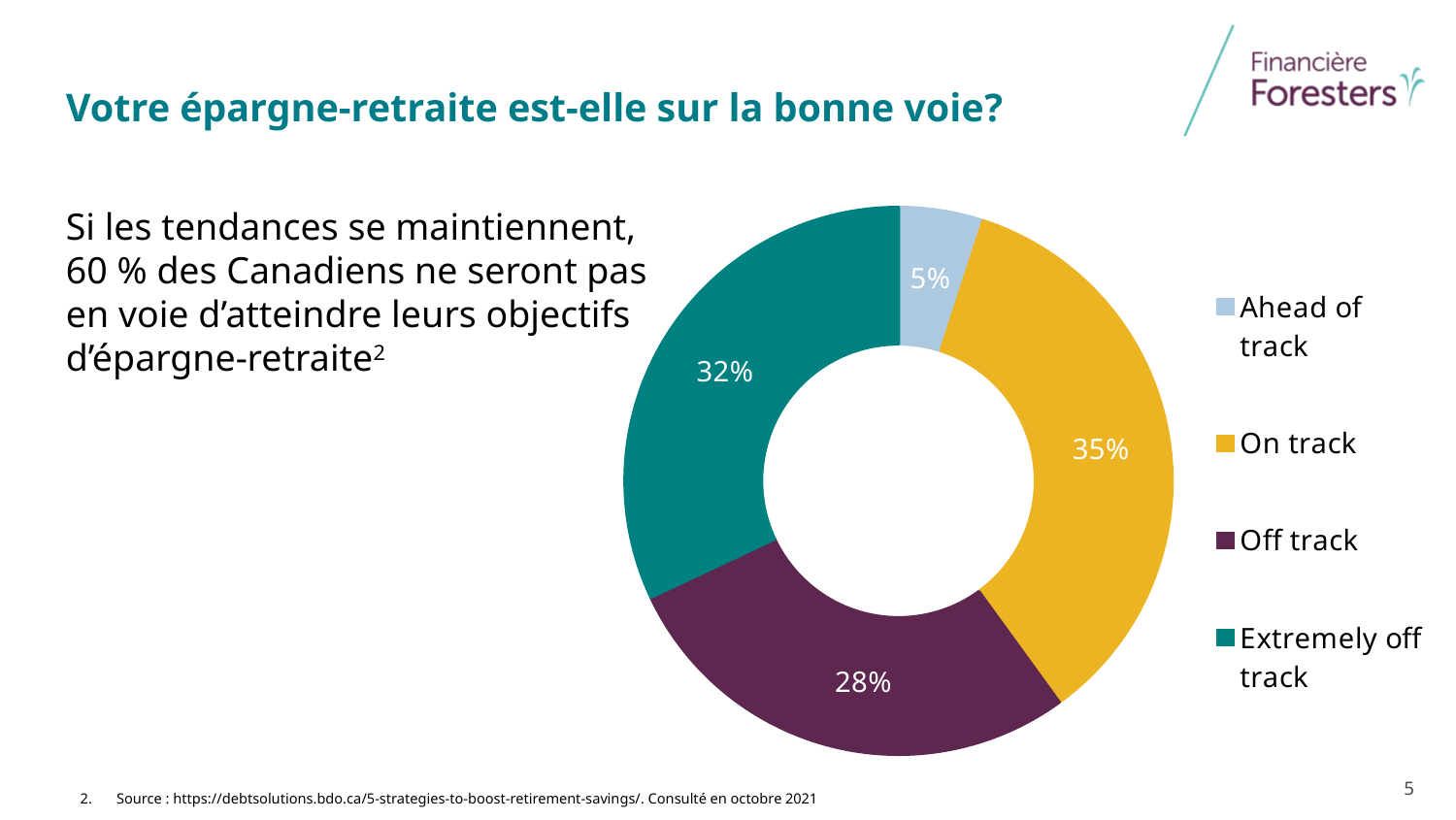
What share of the chart is labelled "On track"? 35% Which is larger: the share for "On track" or the share for "Extremely off track"? On track What share of the chart is labelled "Off track"? 28% Which category has the smallest share of the chart? Ahead of track Which category has the largest share of the chart? On track What kind of chart is shown on the slide? Doughnut (pie) chart How many categories does the chart show? 4 What is the difference in percentage points between "Extremely off track" and "Off track"? 4 percentage points What share of the chart is labelled "Ahead of track"? 5% What share of the chart is labelled "Extremely off track"? 32% What is the combined share of "Off track" and "Extremely off track"? 60% What colour is the "On track" segment of the chart? Yellow